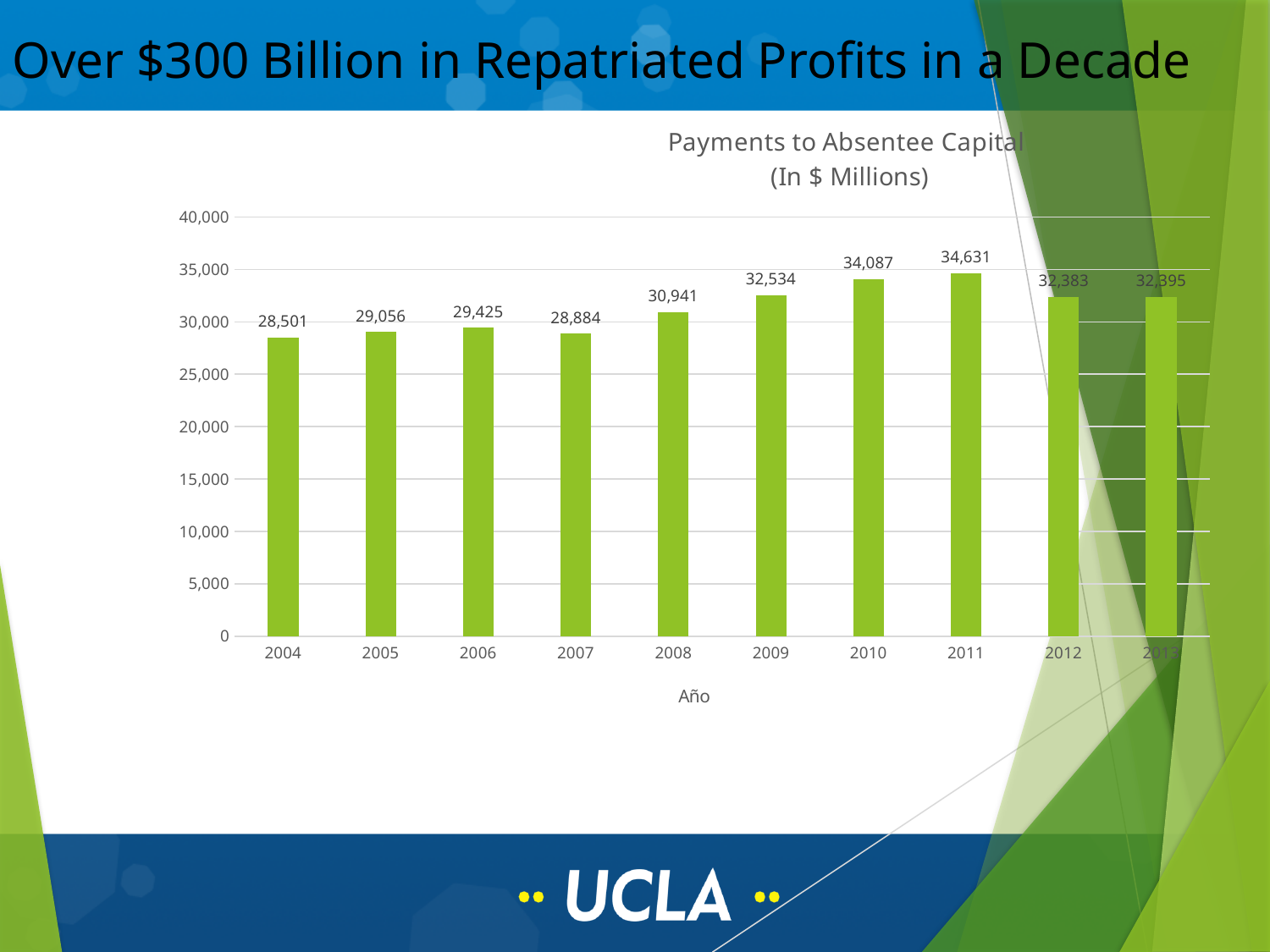
What is the value for 2004 in the Payments to Absentee Capital chart? 28,501 What is the value for 2011 in the Payments to Absentee Capital chart? 34,631 Which year has the highest value in the Payments to Absentee Capital chart? 2011 What is the value for 2008 in the Payments to Absentee Capital chart? 30,941 How many years are shown in the Payments to Absentee Capital chart? 10 Which is larger in the Payments to Absentee Capital chart, the value for 2006 or the value for 2007? 2006 What kind of chart is the Payments to Absentee Capital chart? Bar chart What is the difference between the values for 2011 and 2010 in the Payments to Absentee Capital chart? 544 Which year has the lowest value in the Payments to Absentee Capital chart? 2004 What is the difference between the values for 2009 and 2008 in the Payments to Absentee Capital chart? 1,593 What is the x-axis title of the Payments to Absentee Capital chart? Año Is the value for 2008 in the Payments to Absentee Capital chart greater or less than 30,000? greater